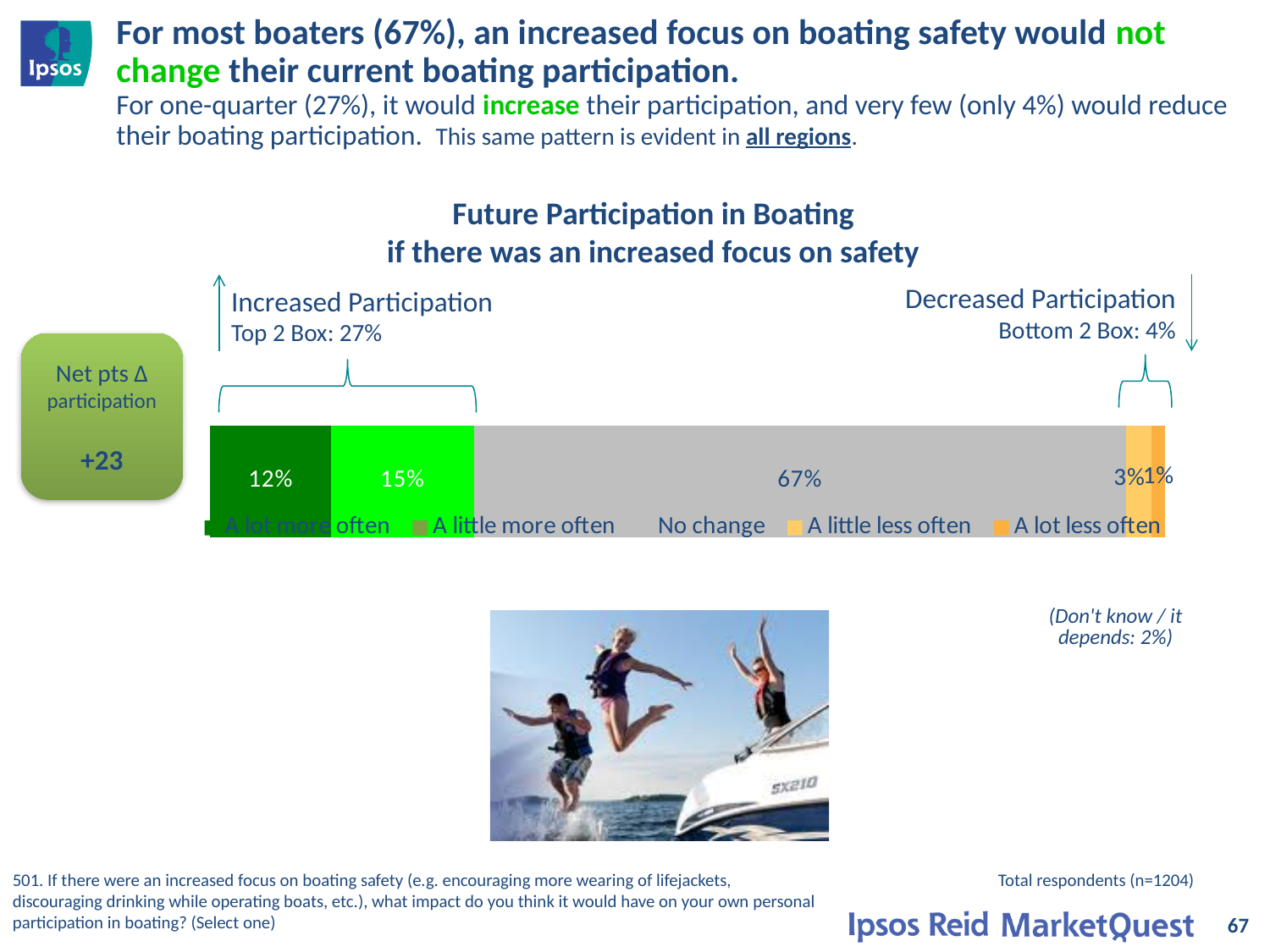
What is the value for "A little less often"? 3% What is the title of the chart? Future Participation in Boating if there was an increased focus on safety Which response category has the largest share? No change How many series does the legend list? 5 What is the value for "A lot less often"? 1% Which is larger, "A little more often" or "A little less often"? A little more often What is the value for "A lot more often"? 12% What kind of chart is shown on the slide? Stacked bar chart What is the value for "A little more often"? 15% What is the difference between "A little more often" and "A lot more often"? 3% Which response category has the smallest share? A lot less often What percentage of boaters said there would be no change in their participation? 67%